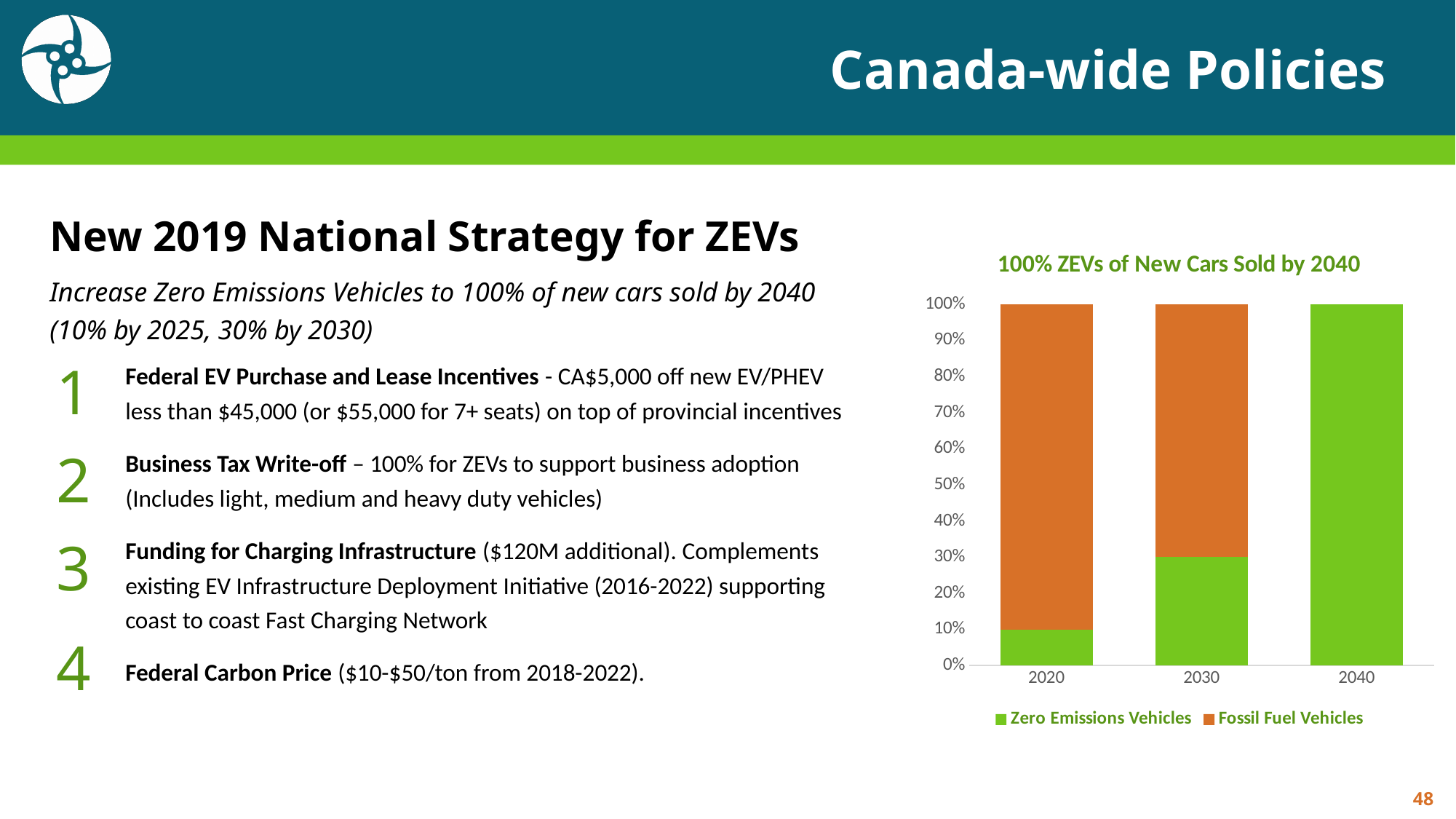
Which year has the highest share of Zero Emissions Vehicles? 2040 How many years are shown on the x axis of the chart? 3 How many series does the chart legend list? 2 Is the Zero Emissions Vehicles value for 2020 greater or less than 20%? less What kind of chart is shown on the slide? stacked bar chart What share of new cars sold are Zero Emissions Vehicles in 2030 according to the chart? 30% Is the Fossil Fuel Vehicles value for 2020 greater or less than 80%? greater Does the Zero Emissions Vehicles share rise or fall from 2020 to 2040? rise What share of new cars sold are Fossil Fuel Vehicles in 2030 according to the chart? 70% What share of new cars sold are Zero Emissions Vehicles in 2040 according to the chart? 100% What is the title of the chart? 100% ZEVs of New Cars Sold by 2040 Which year has the lowest share of Zero Emissions Vehicles? 2020